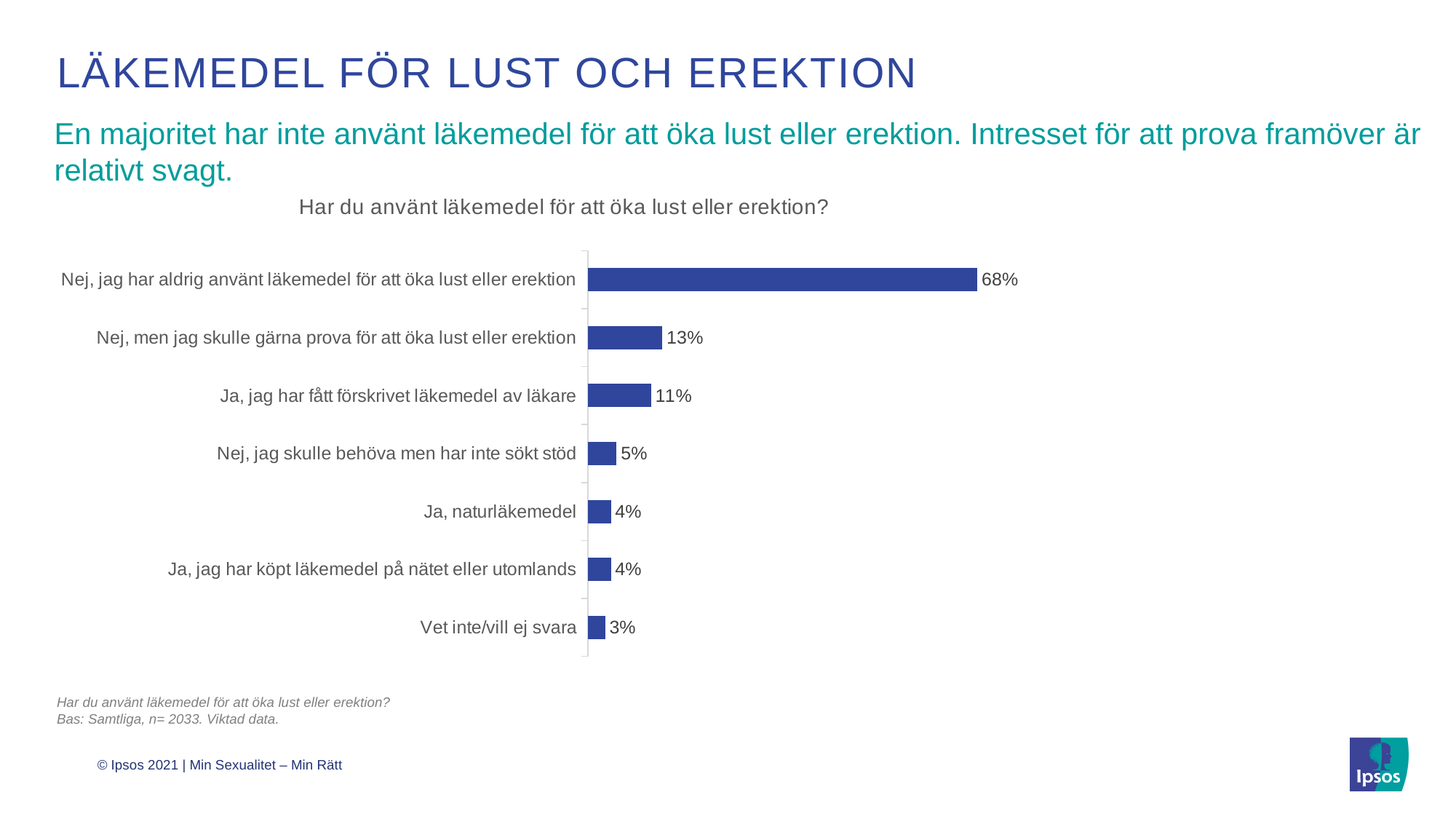
What is the title of the chart? Har du använt läkemedel för att öka lust eller erektion? What is the value for "Nej, men jag skulle gärna prova för att öka lust eller erektion"? 13% What is the difference between "Nej, jag har aldrig använt läkemedel för att öka lust eller erektion" and "Nej, men jag skulle gärna prova för att öka lust eller erektion"? 55 percentage points What is the value for "Vet inte/vill ej svara"? 3% What percentage of respondents answered "Nej, jag har aldrig använt läkemedel för att öka lust eller erektion"? 68% Which is larger: "Ja, jag har fått förskrivet läkemedel av läkare" or "Nej, jag skulle behöva men har inte sökt stöd"? Ja, jag har fått förskrivet läkemedel av läkare Which category has the lowest value? Vet inte/vill ej svara What kind of chart is shown on the slide? Bar chart What is the value for "Ja, jag har fått förskrivet läkemedel av läkare"? 11% What is the difference between "Nej, jag skulle behöva men har inte sökt stöd" and "Ja, naturläkemedel"? 1 percentage point Which category has the highest value? Nej, jag har aldrig använt läkemedel för att öka lust eller erektion How many categories are shown in the chart? 7